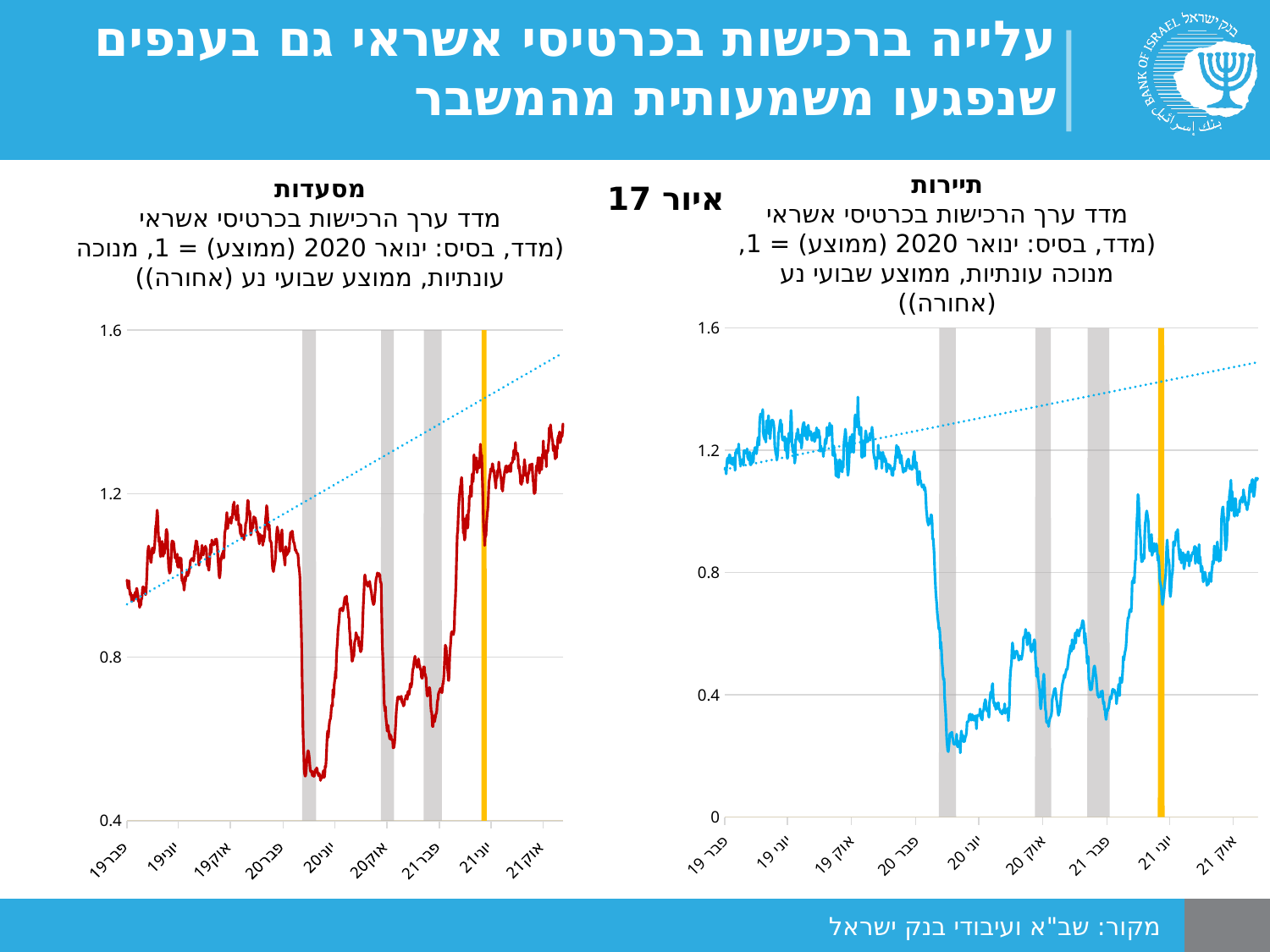
In the right chart (תיירות), is the value at פבר 19 greater or less than 0.8? greater In the left chart (מסעדות), does the line rise or fall between יוני 21 and אוק 21? Rises In the left chart (מסעדות), is the lowest point of the line greater or less than 0.8? less What colour is the data line in the left chart (מסעדות)? Red In the right chart (תיירות), is the lowest point of the line greater or less than 0.4? less In the right chart (תיירות), which is larger: the value at פבר 19 or the value at יוני 20? פבר 19 In the left chart (מסעדות), which is larger: the value at אוק 21 or the value at פבר 19? אוק 21 What kind of chart is the right chart (תיירות)? Line chart How many date labels are shown on the x axis of the right chart (תיירות)? 9 What kind of chart is the left chart (מסעדות)? Line chart In the right chart (תיירות), does the line rise or fall between פבר 20 and יוני 20? Falls